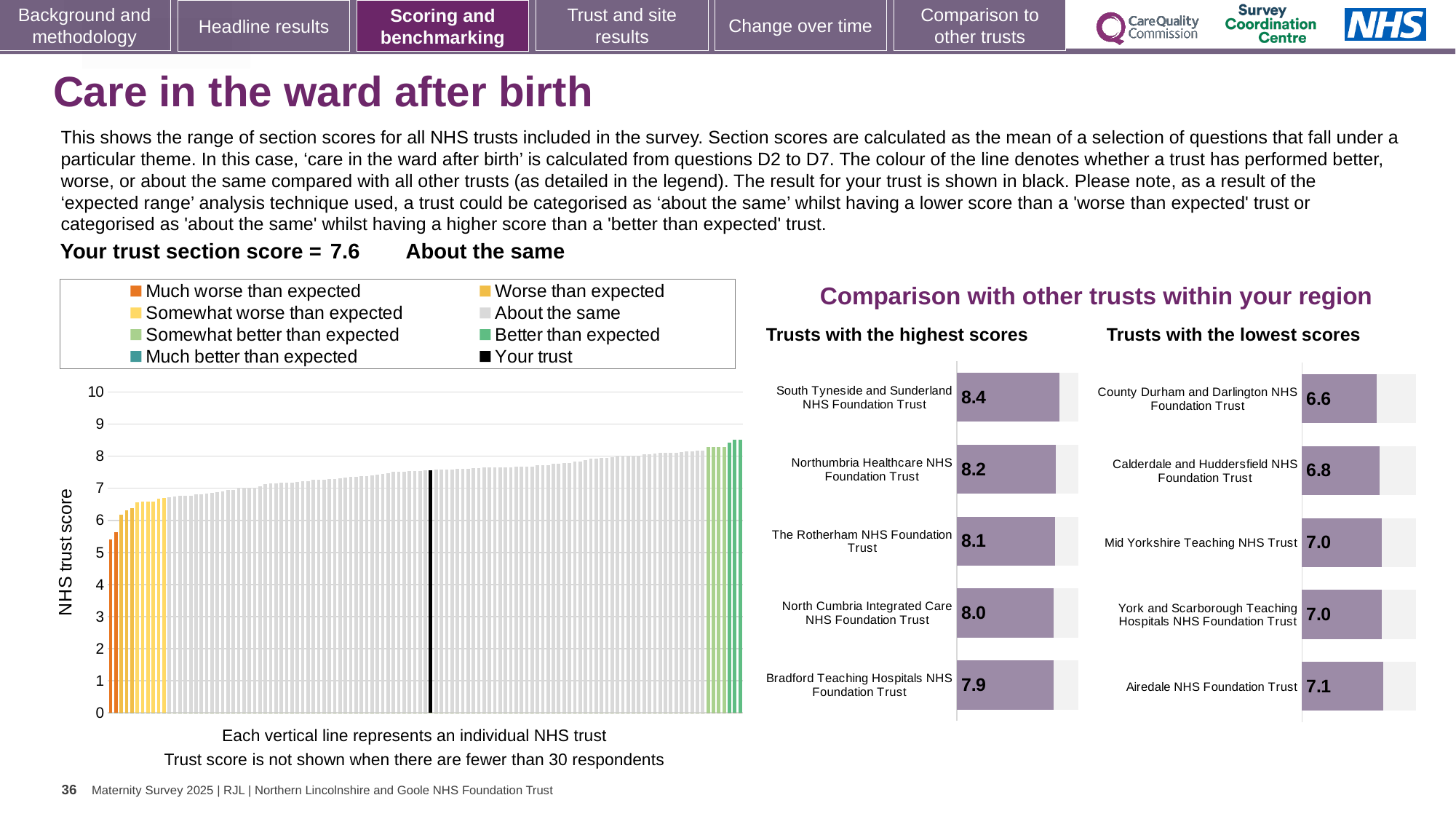
How many trusts are shown in the 'Trusts with the highest scores' chart? 5 In the 'Trusts with the lowest scores' chart, what is the difference between the scores of Airedale NHS Foundation Trust and County Durham and Darlington NHS Foundation Trust? 0.5 How many entries does the legend of the 'NHS trust score' chart on the left list? 8 In the 'Trusts with the lowest scores' chart, which has the larger score: Calderdale and Huddersfield NHS Foundation Trust or Mid Yorkshire Teaching NHS Trust? Mid Yorkshire Teaching NHS Trust In the 'NHS trust score' chart on the left, what is the section score for the trust shown in black (your trust)? 7.6 In the 'Trusts with the highest scores' chart, which trust has the highest score? South Tyneside and Sunderland NHS Foundation Trust In the 'Trusts with the lowest scores' chart, what is the score for Airedale NHS Foundation Trust? 7.1 What kind of chart is the 'NHS trust score' chart on the left of the slide? bar chart In the 'Trusts with the highest scores' chart, what is the score for South Tyneside and Sunderland NHS Foundation Trust? 8.4 In the 'NHS trust score' chart on the left, do the values rise or fall from left to right? rise In the 'Trusts with the highest scores' chart, what is the difference between the scores of South Tyneside and Sunderland NHS Foundation Trust and Bradford Teaching Hospitals NHS Foundation Trust? 0.5 In the 'Trusts with the lowest scores' chart, which trust has the lowest score? County Durham and Darlington NHS Foundation Trust